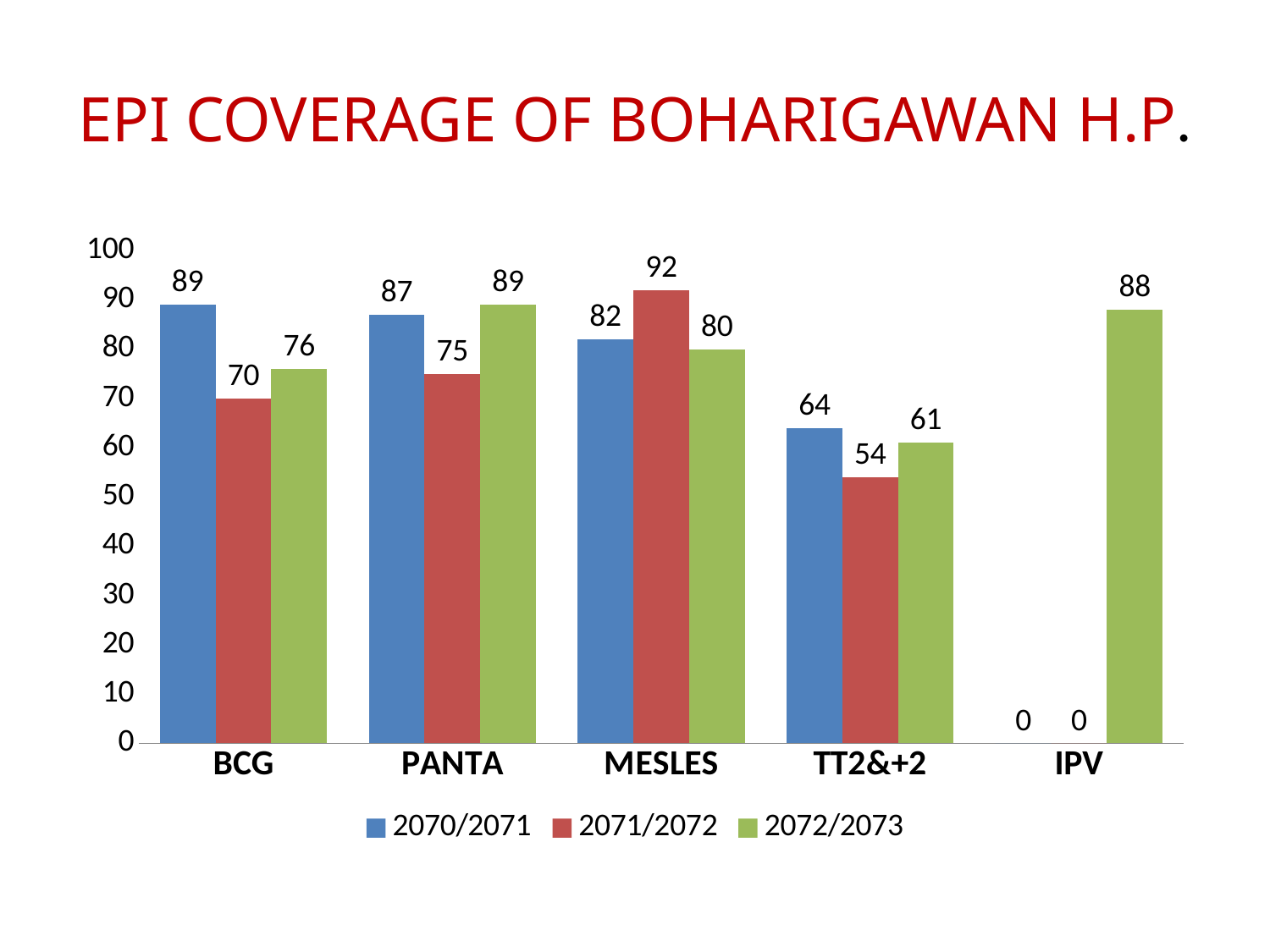
What is the value for IPV in the 2072/2073 series? 88 What is the value for MESLES in the 2071/2072 series? 92 What is the title of the chart? EPI COVERAGE OF BOHARIGAWAN H.P. How many categories are shown on the x axis? 5 Which category has the highest value in the 2071/2072 series? MESLES What kind of chart is shown on the slide? Bar chart How many series does the legend list? 3 Which category has the lowest value in the 2072/2073 series? TT2&+2 What is the difference between the 2070/2071 and 2071/2072 values for BCG? 19 What is the value for TT2&+2 in the 2071/2072 series? 54 What is the value for BCG in the 2070/2071 series? 89 Which is larger for PANTA: the 2070/2071 value or the 2072/2073 value? 2072/2073